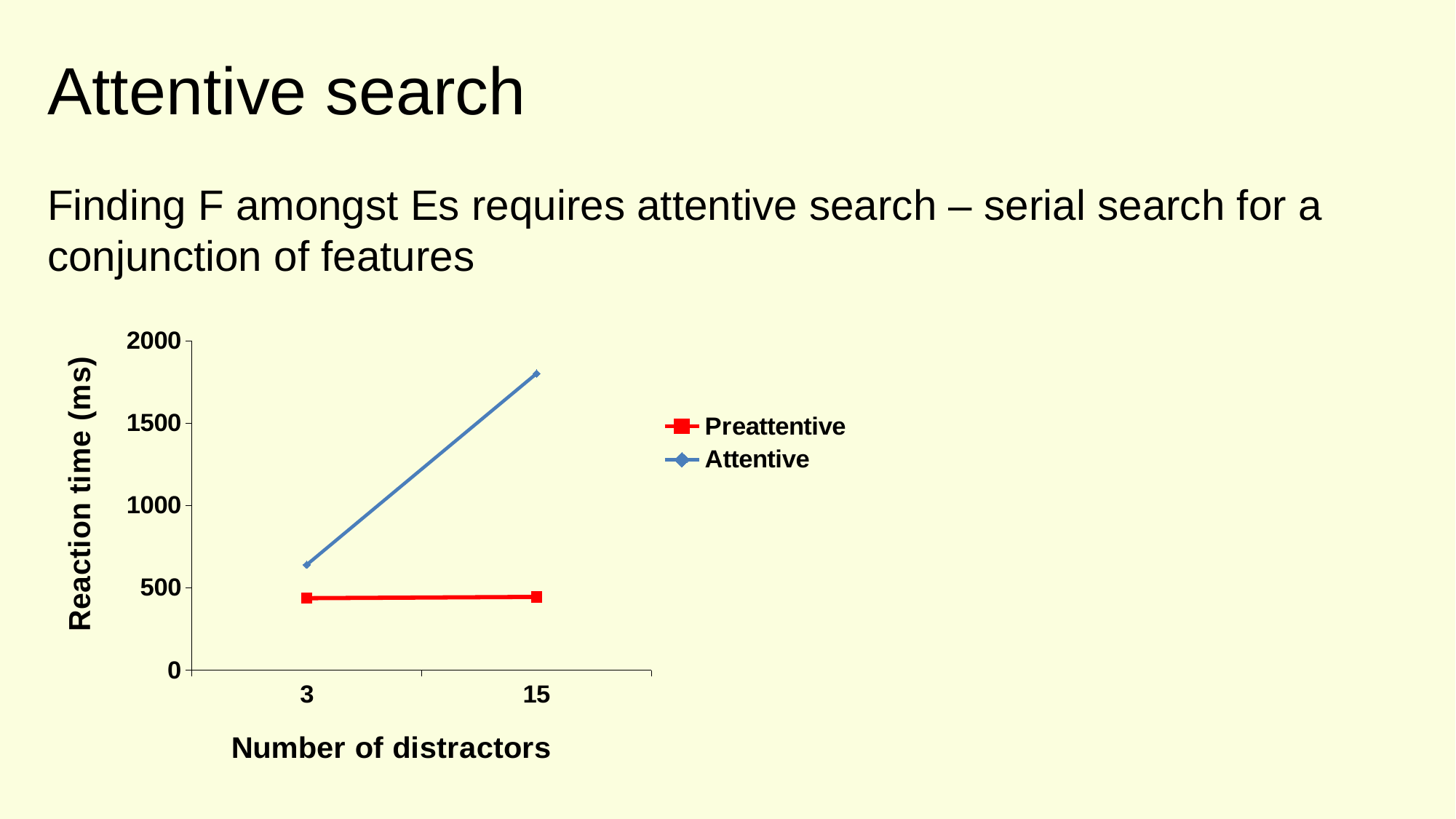
Does the Attentive series rise or fall as the number of distractors increases from 3 to 15? rise What is the label of the y axis? Reaction time (ms) What is the label of the x axis? Number of distractors Is the Attentive reaction time at 3 distractors greater or less than 1000? less Is the Preattentive reaction time at 15 distractors greater or less than 500? less How many points are plotted along the x axis for each series? 2 Is the Attentive reaction time at 15 distractors greater or less than 1500? greater What kind of chart is shown on the slide? line chart Which series has the higher reaction time at 15 distractors? Attentive Which series has the higher reaction time at 3 distractors? Attentive How many series does the legend list? 2